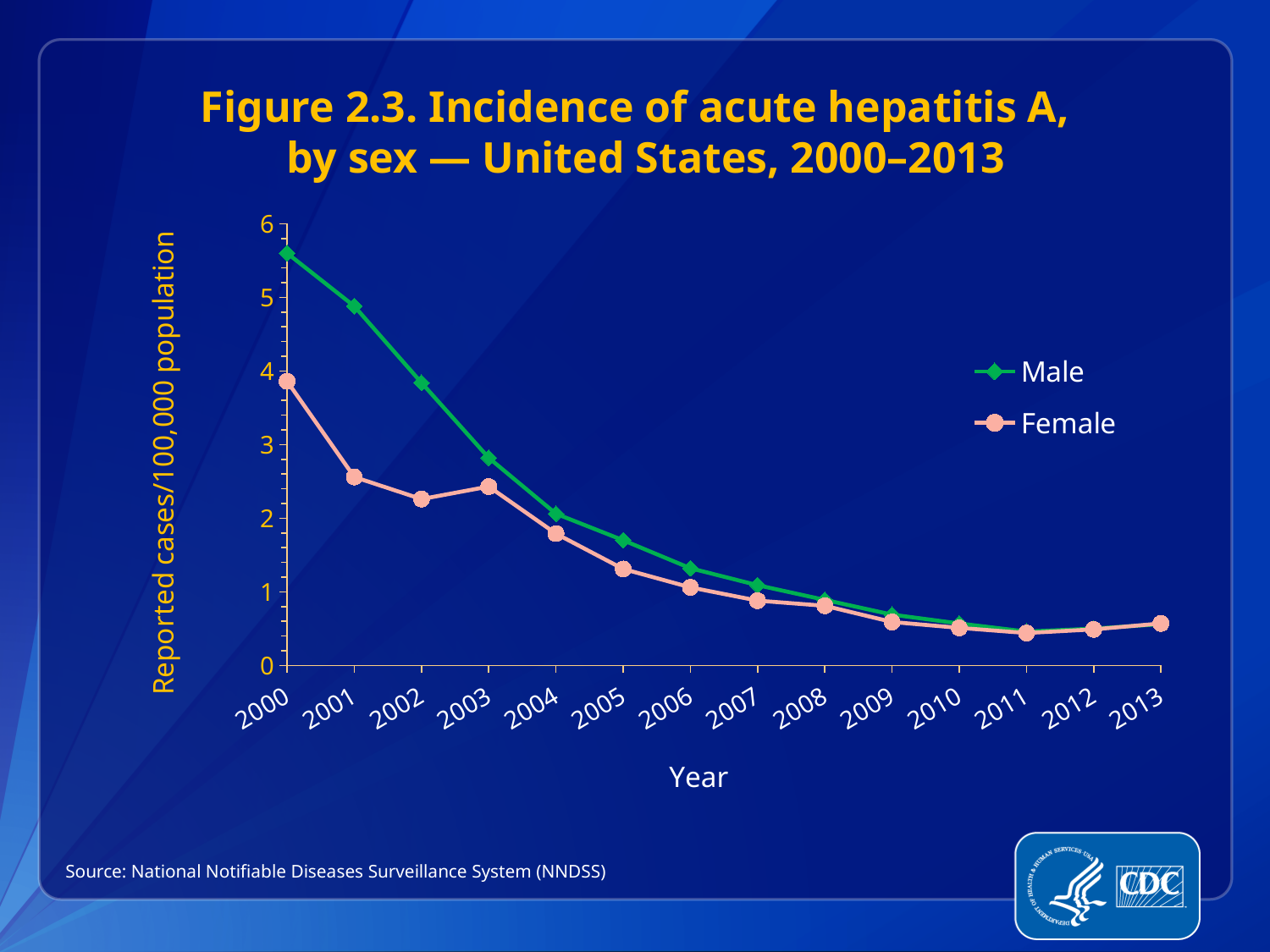
How many series does the legend list? 2 Is the Female value for 2001 greater or less than 2? greater What kind of chart is shown on the slide? line chart In which year is the Female incidence rate highest? 2000 Is the Male value for 2000 greater or less than 5? greater In 2002, which series has the higher value, Male or Female? Male How many years are plotted along the x axis? 14 Is the Female value for 2013 greater or less than 1? less Overall, does the Male incidence rate rise or fall from 2000 to 2013? fall What is the label of the y axis? Reported cases/100,000 population In which year is the Male incidence rate highest? 2000